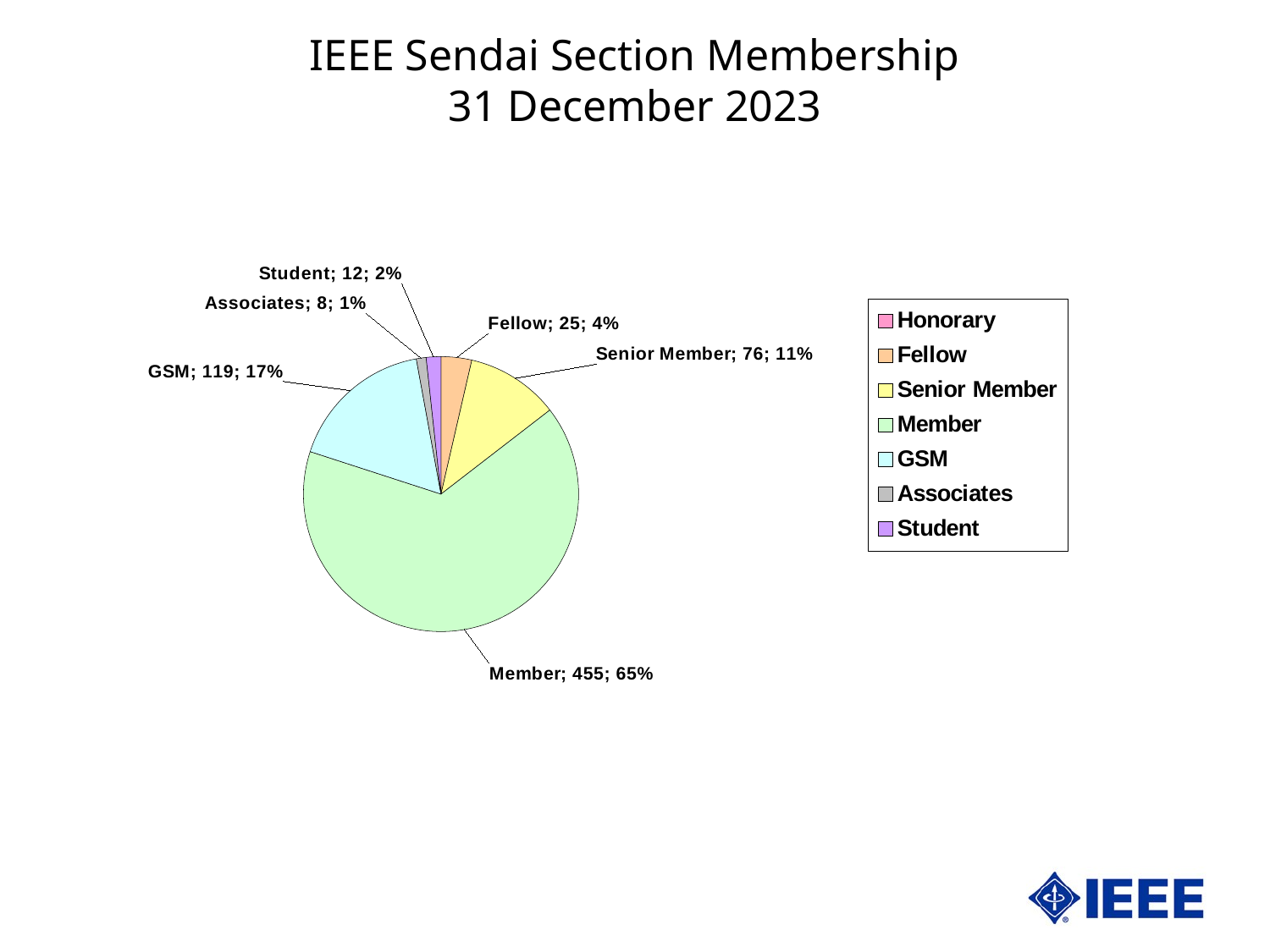
What percentage share does the Member slice represent? 65% How many members are in the Member category? 455 What is the difference between the GSM count and the Senior Member count? 43 Which category has the largest slice of the pie? Member How many Senior Members are shown? 76 How many entries does the legend list? 7 Which is larger, the Student count or the Fellow count? Fellow What type of chart is shown on the slide? pie chart Which labelled category has the smallest slice of the pie? Associates What percentage share of the pie does GSM have? 17% What is the value for Fellow? 25 What is the title of the slide? IEEE Sendai Section Membership 31 December 2023